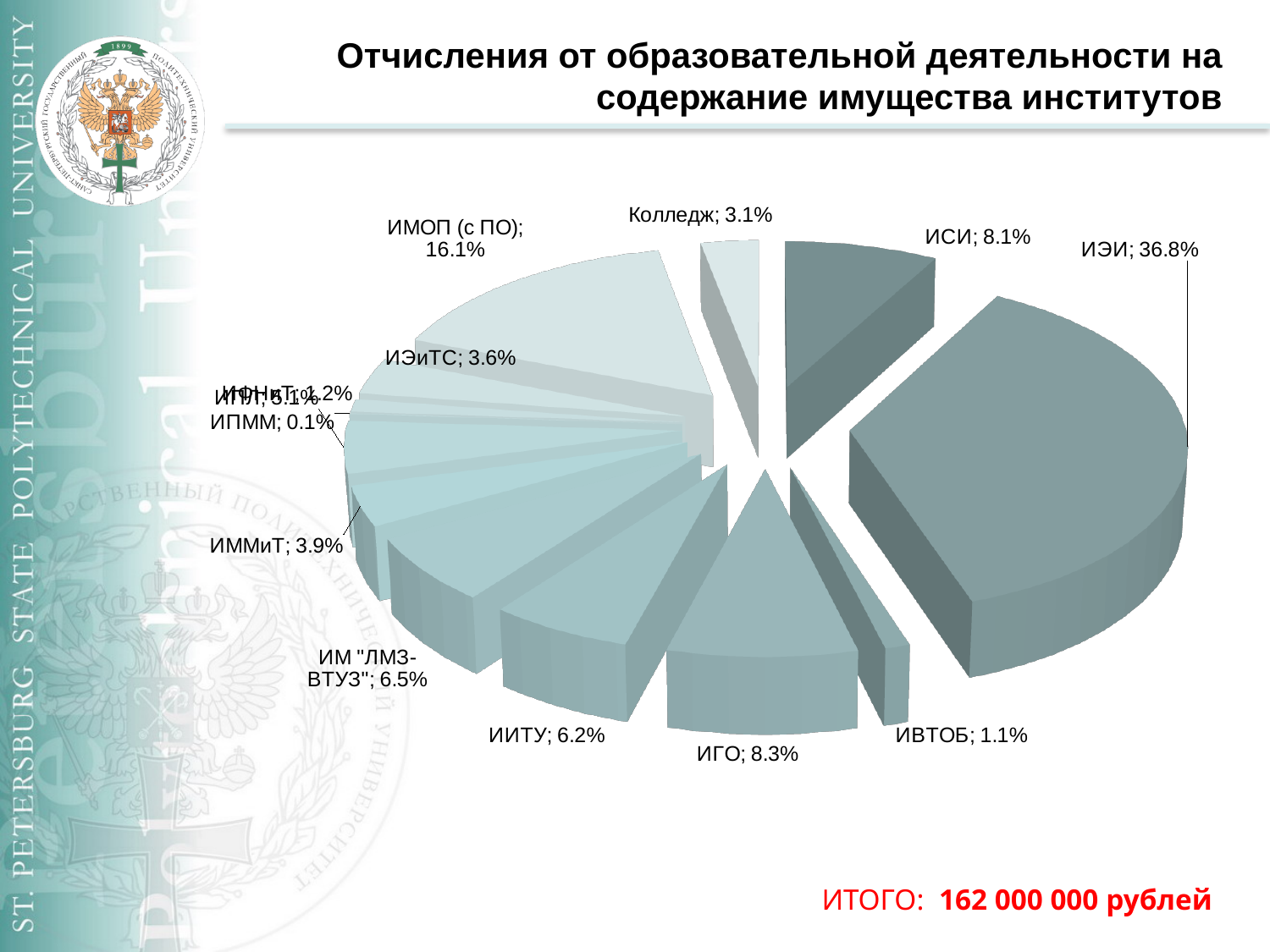
What is the value shown for Колледж? 3.1% What share of the pie does ИЭИ have? 36.8% What total amount (ИТОГО) is stated on the slide? 162 000 000 рублей What kind of chart is shown on the slide? Pie chart What is the value shown for ИВТОБ? 1.1% Which has a larger share, ИИТУ or ИМ "ЛМЗ-ВТУЗ"? ИМ "ЛМЗ-ВТУЗ" Which category has the largest share of the pie? ИЭИ Which category has the smallest share of the pie? ИПММ What is the value shown for ИГО? 8.3% Which has a larger share, ИСИ or ИГО? ИГО What is the difference between the shares of ИЭИ and ИМОП (с ПО)? 20.7% What is the value shown for ИМОП (с ПО)? 16.1%